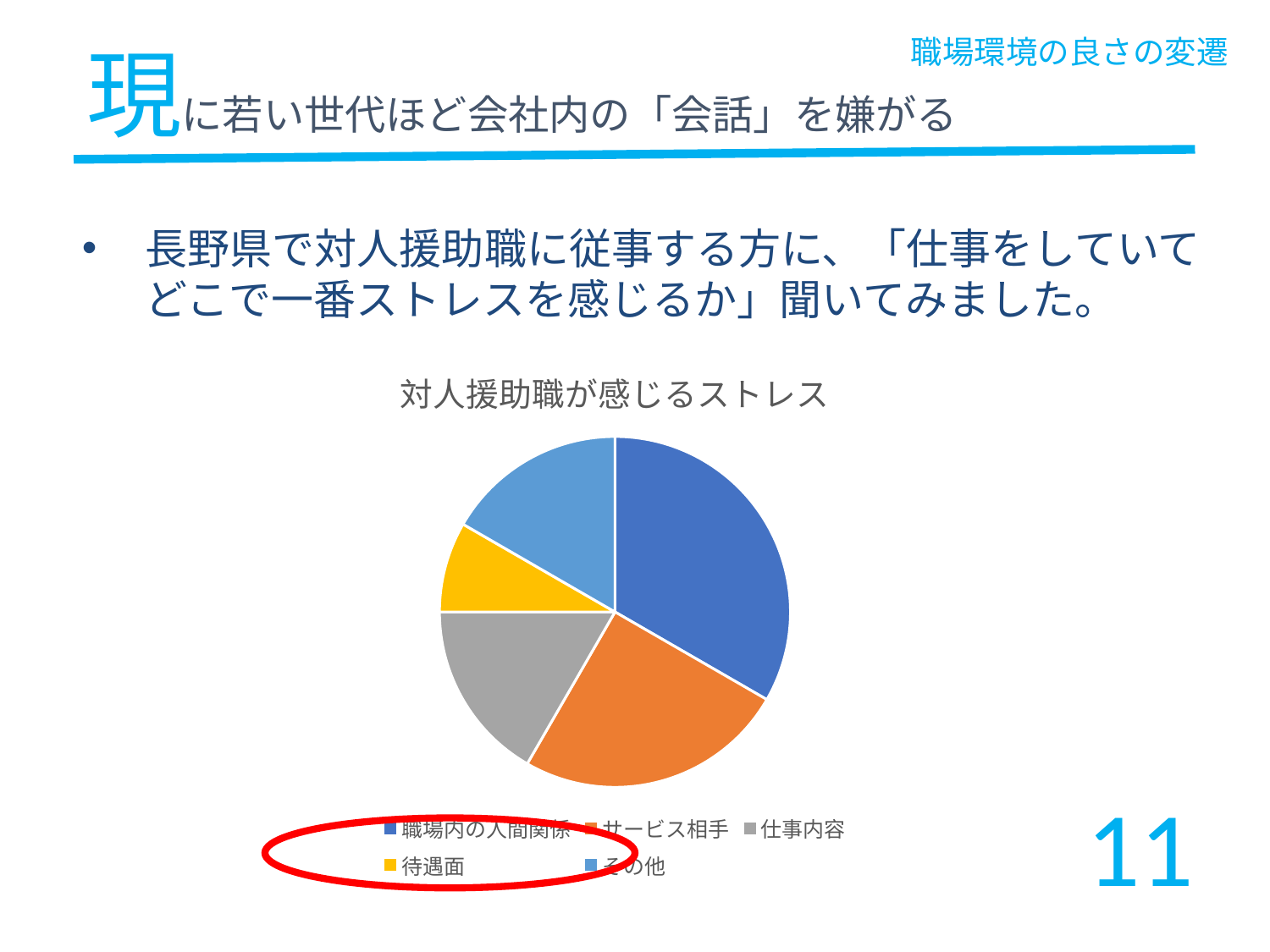
What colour is the slice for 待遇面 in the pie chart? yellow Which slice is larger, 仕事内容 or 待遇面? 仕事内容 Which slice is larger, 職場内の人間関係 or サービス相手? 職場内の人間関係 Which category has the smallest slice in the pie chart? 待遇面 How many slices does the pie chart have? 5 Which slice is larger, サービス相手 or 仕事内容? サービス相手 Which category has the largest slice in the pie chart? 職場内の人間関係 How many entries does the legend of the pie chart list? 5 What kind of chart is shown on the slide? pie chart What is the title of the pie chart? 対人援助職が感じるストレス